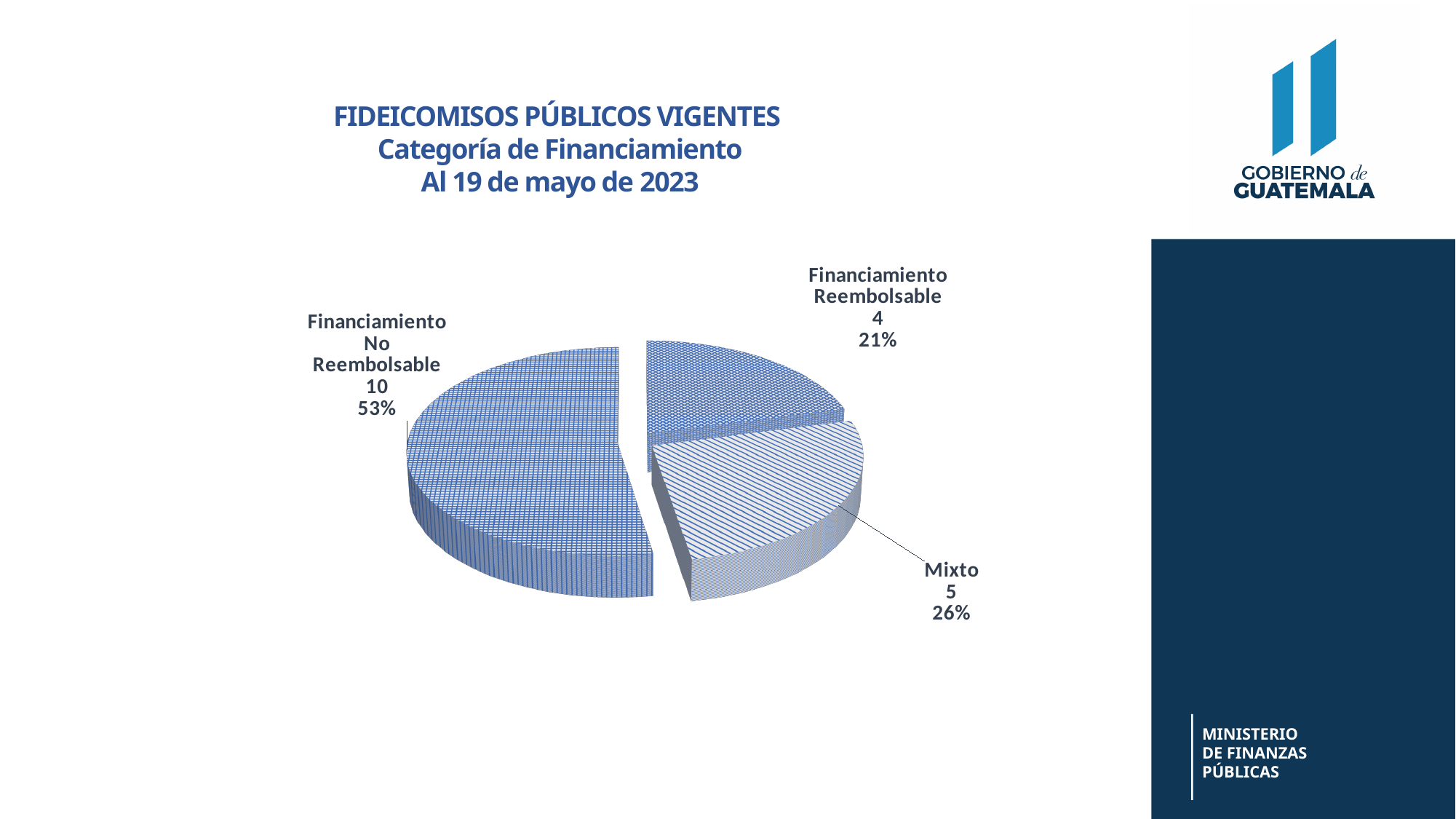
What is the value for Financiamiento Reembolsable? 4 What is the date given in the chart title? 19 de mayo de 2023 Which category has the smallest slice? Financiamiento Reembolsable Which category has the largest slice? Financiamiento No Reembolsable What is the value for Mixto? 5 What kind of chart is shown on the slide? Pie chart What share of the pie does Mixto represent? 26% What is the value for Financiamiento No Reembolsable? 10 How many categories does the pie chart show? 3 What share of the pie does Financiamiento Reembolsable represent? 21% What is the difference between the values for Financiamiento No Reembolsable and Mixto? 5 What share of the pie does Financiamiento No Reembolsable represent? 53%